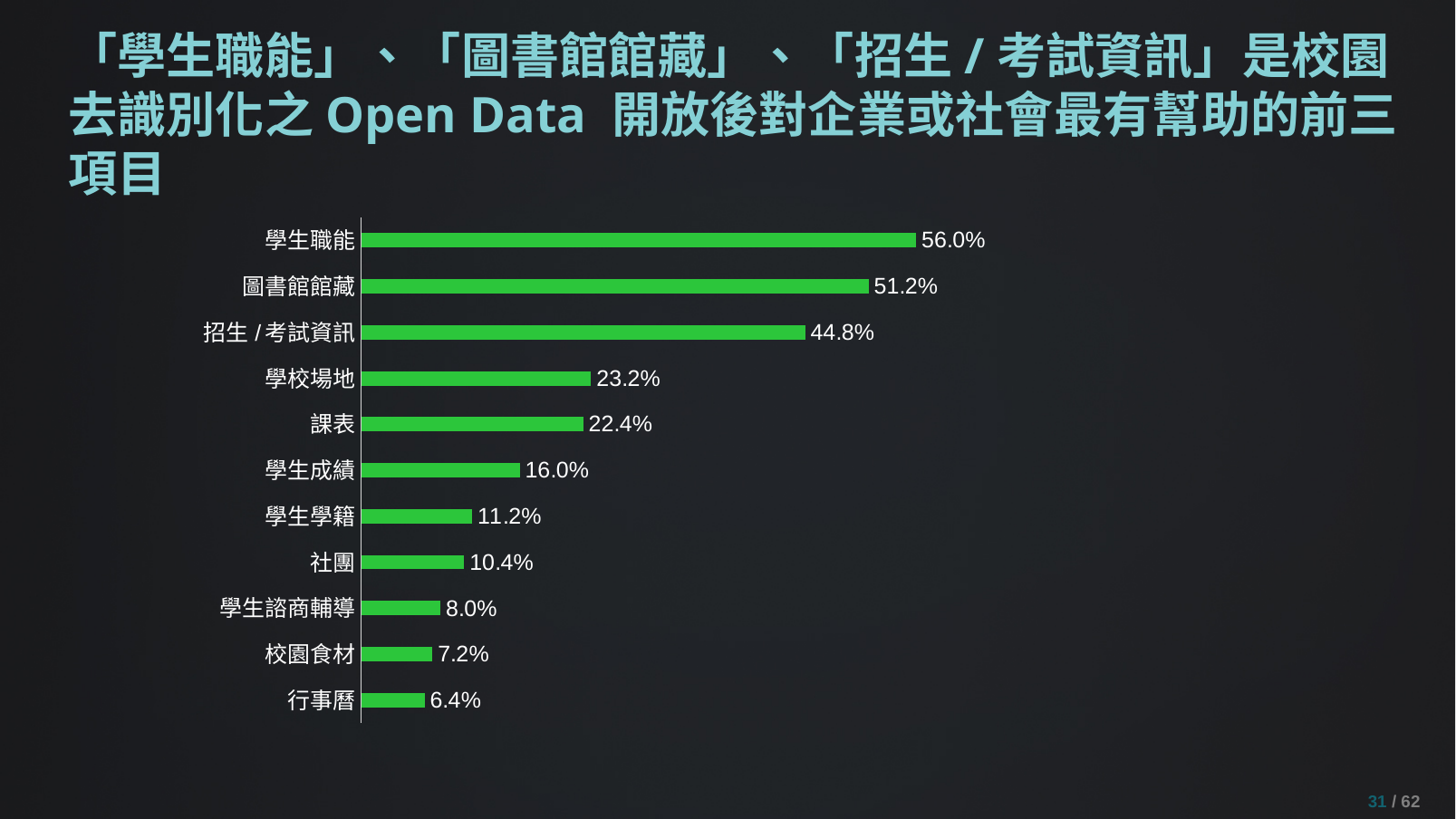
What is the difference between the values for 學生職能 and 圖書館館藏? 4.8% What is the difference between the values for 學校場地 and 學生成績? 7.2% How many categories are shown in the chart? 11 What kind of chart is shown on the slide? Bar chart What is the value for 招生 / 考試資訊? 44.8% What is the value for 校園食材? 7.2% What colour are the bars in the chart? Green Which is larger, the value for 學生學籍 or the value for 社團? 學生學籍 What is the value for 學生職能? 56.0% Which category has the lowest value? 行事曆 What is the value for 課表? 22.4% Which category has the highest value? 學生職能